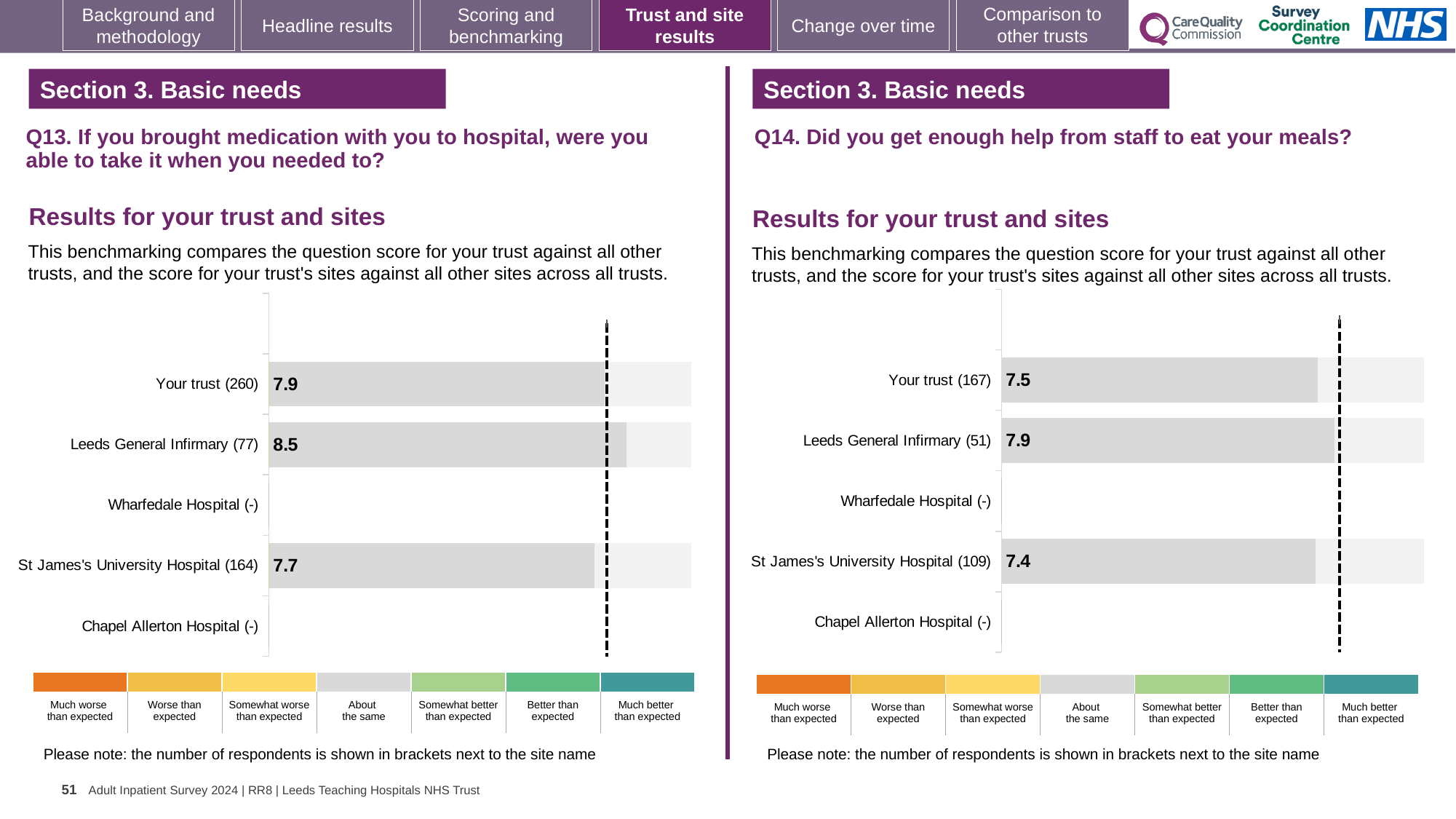
On the Q13 chart (left), what is the score for Leeds General Infirmary? 8.5 What kind of chart is used on the Q14 chart (right)? bar chart On the Q13 chart (left), what is the difference between the scores for Leeds General Infirmary and St James's University Hospital? 0.8 On the Q14 chart (right), which of the scored sites or trust has the lowest score? St James's University Hospital On the Q13 chart (left), which site or trust has the highest score? Leeds General Infirmary On the Q14 chart (right), what is the score for Your trust? 7.5 On the Q14 chart (right), is the score for Leeds General Infirmary larger or smaller than the score for Your trust? larger On the Q13 chart (left), what is the score for St James's University Hospital? 7.7 On the Q14 chart (right), what is the score for Leeds General Infirmary? 7.9 How many categories (trust and sites) are listed on the Q13 chart (left)? 5 On the Q13 chart (left), what is the score for Your trust? 7.9 On the Q14 chart (right), what is the score for St James's University Hospital? 7.4